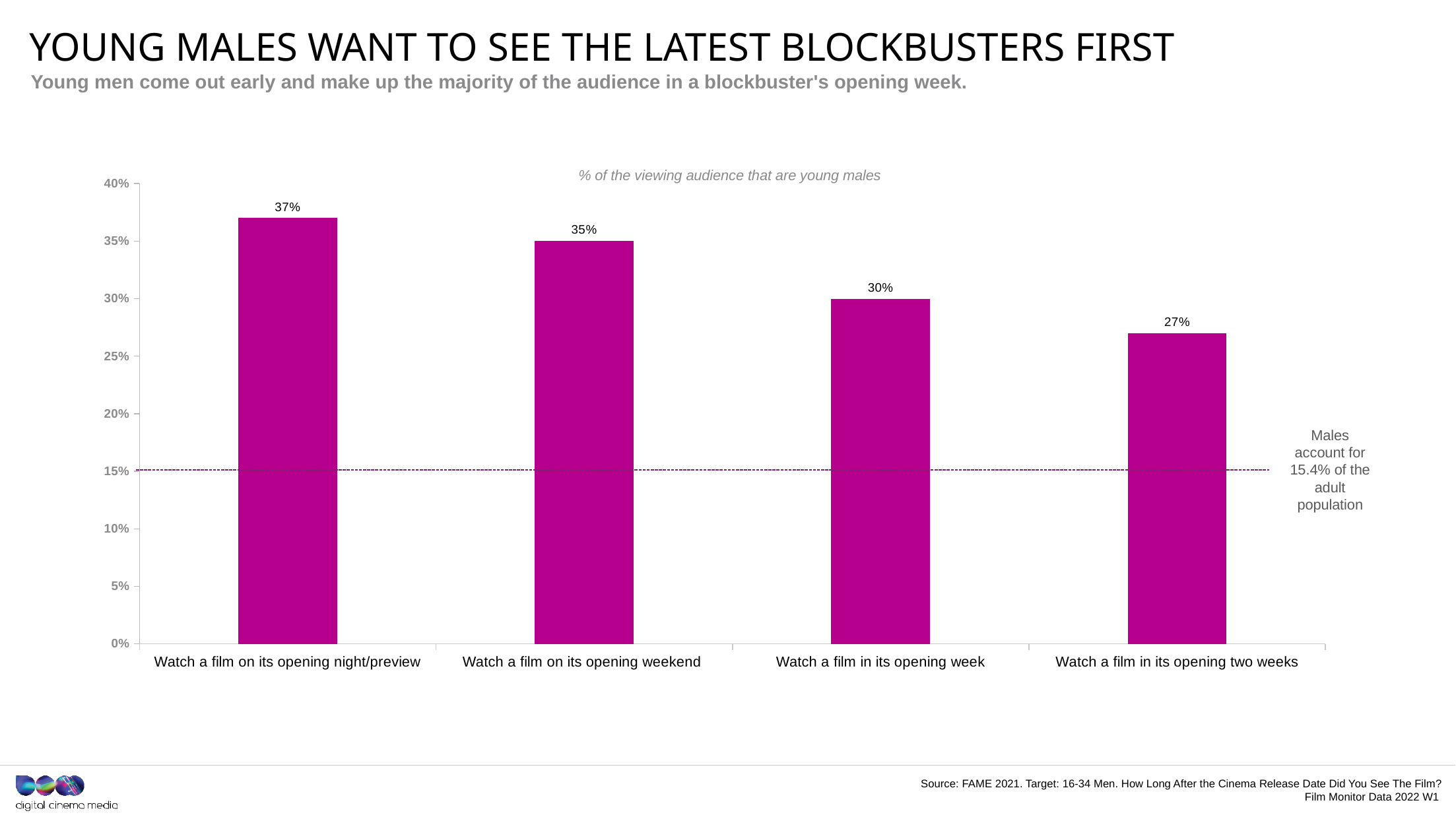
What is the value for 'Watch a film in its opening week'? 30% What percentage of the viewing audience are young males for 'Watch a film on its opening night/preview'? 37% What is the value for 'Watch a film in its opening two weeks'? 27% What is the difference between the values for 'Watch a film on its opening night/preview' and 'Watch a film in its opening two weeks'? 10% According to the dashed reference line annotation, what percentage of the adult population do males account for? 15.4% What is the value for 'Watch a film on its opening weekend'? 35% Which category has the lowest share of young males in the viewing audience? Watch a film in its opening two weeks How many categories are shown on the chart? 4 Do the values rise or fall moving from left to right along the x axis? Fall Which is larger: the value for 'Watch a film on its opening weekend' or 'Watch a film in its opening week'? Watch a film on its opening weekend What kind of chart is shown on the slide? Bar chart Which category has the highest share of young males in the viewing audience? Watch a film on its opening night/preview